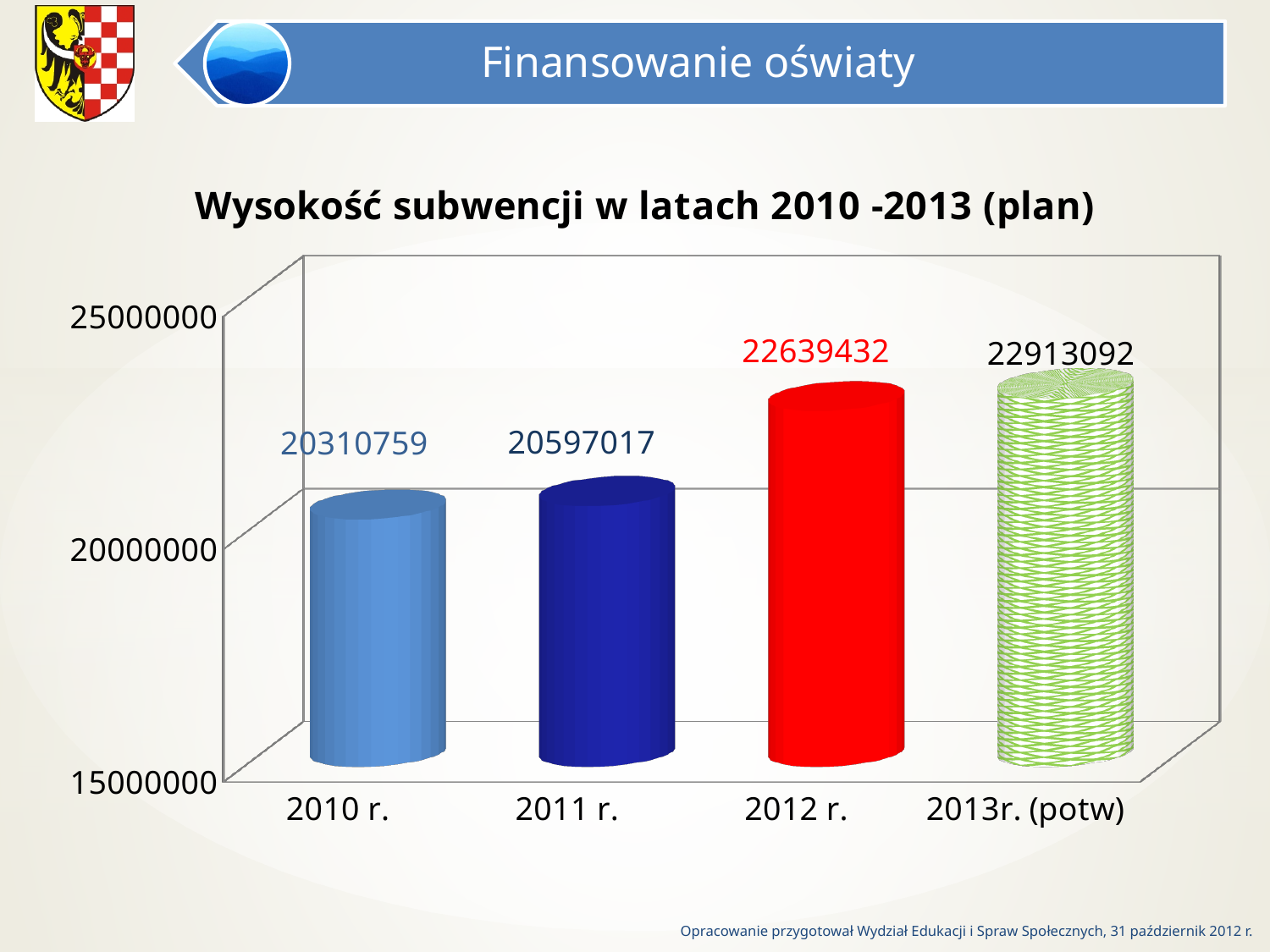
What is the value for 2011 r.? 20597017 Which category has the highest value? 2013r. (potw) Which is larger, the value for 2011 r. or the value for 2012 r.? 2012 r. What is the value for 2010 r.? 20310759 What is the value for 2013r. (potw)? 22913092 Is the value for 2010 r. greater or less than 20000000? greater What is the value for 2012 r.? 22639432 Do the values rise or fall from 2010 r. to 2013r. (potw)? rise What is the difference between the values for 2012 r. and 2011 r.? 2042415 How many categories are shown on the x axis? 4 What is the difference between the values for 2013r. (potw) and 2010 r.? 2602333 Which category has the lowest value? 2010 r.